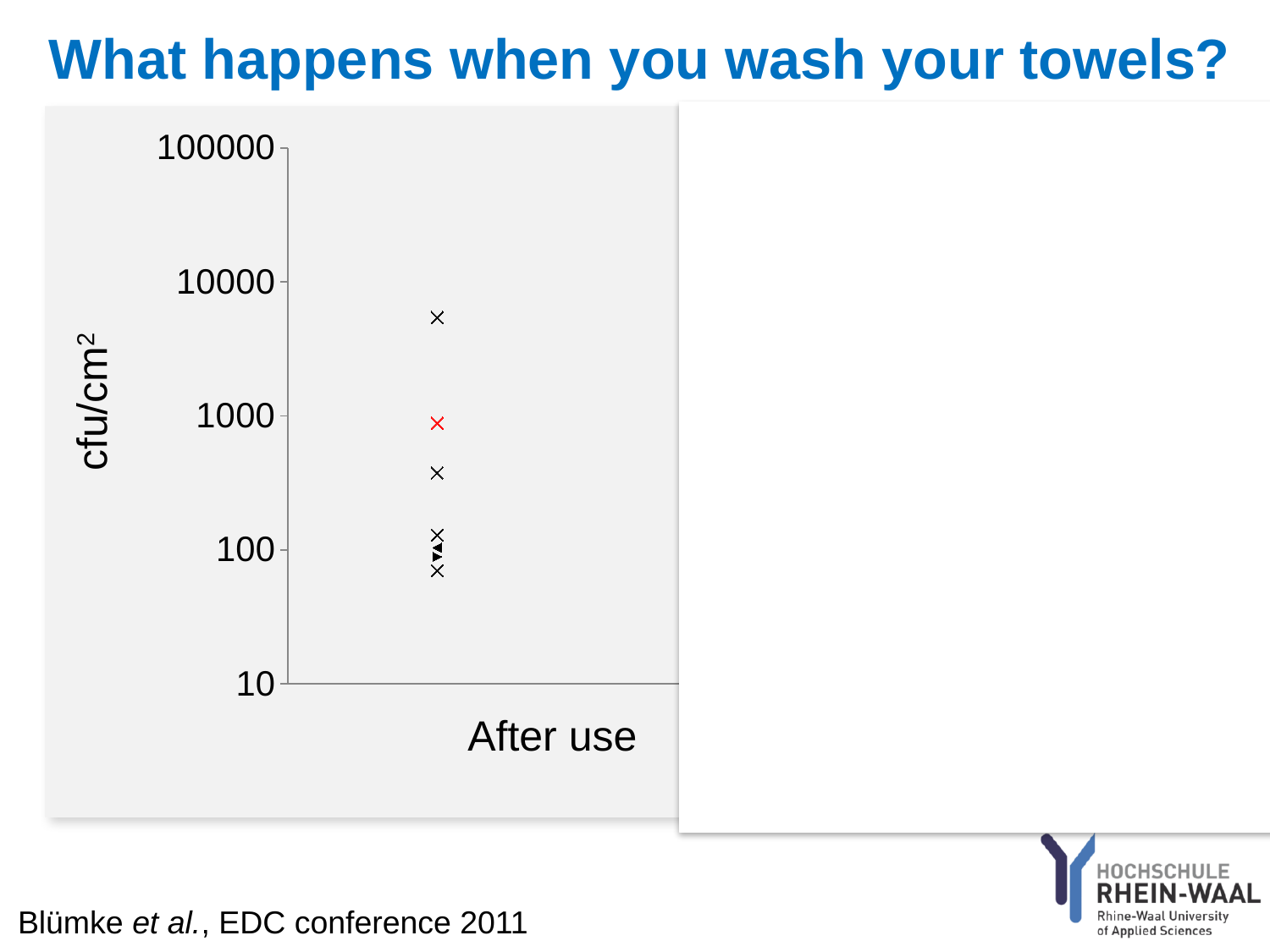
Is the lowest plotted value for After use greater or less than 10? greater What is the lowest tick value shown on the y axis? 10 What is the highest tick value shown on the y axis? 100000 Is the red marker for After use greater or less than 100? greater Is the highest plotted value for After use greater or less than 1000? greater What is the label on the y axis of the chart? cfu/cm² What kind of chart is shown on the slide? scatter plot